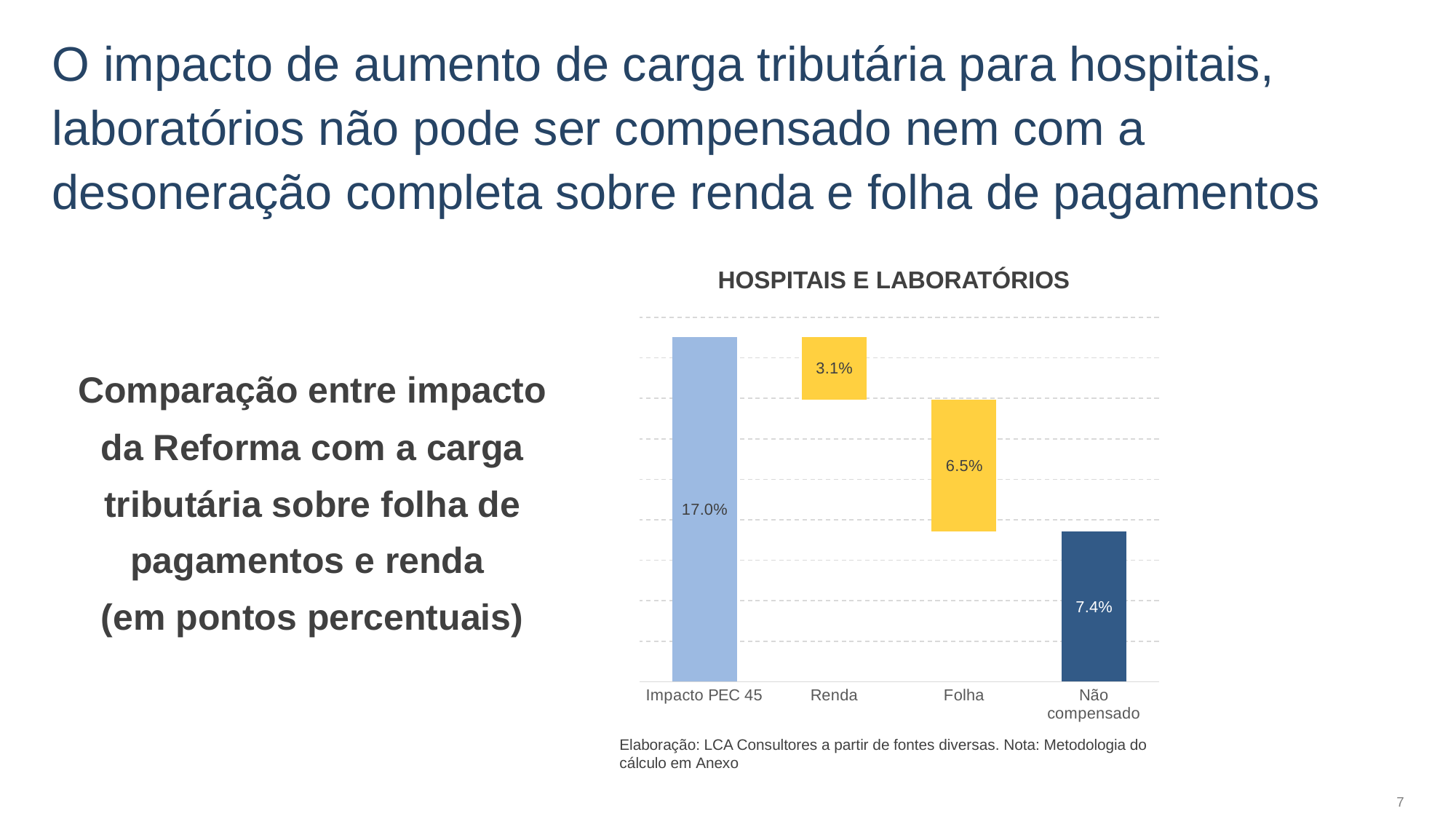
What is the difference between the values for Impacto PEC 45 and Não compensado? 9.6% Which is larger, the value for Folha or the value for Não compensado? Não compensado Which category has the lowest value? Renda What kind of chart is shown? bar chart What is the value shown for Não compensado? 7.4% Which category has the highest value? Impacto PEC 45 What is the title of the chart? HOSPITAIS E LABORATÓRIOS What is the difference between the values for Folha and Renda? 3.4% What is the value shown for Impacto PEC 45? 17.0% What is the value shown for Renda? 3.1% What is the value shown for Folha? 6.5% How many categories are shown on the x axis? 4